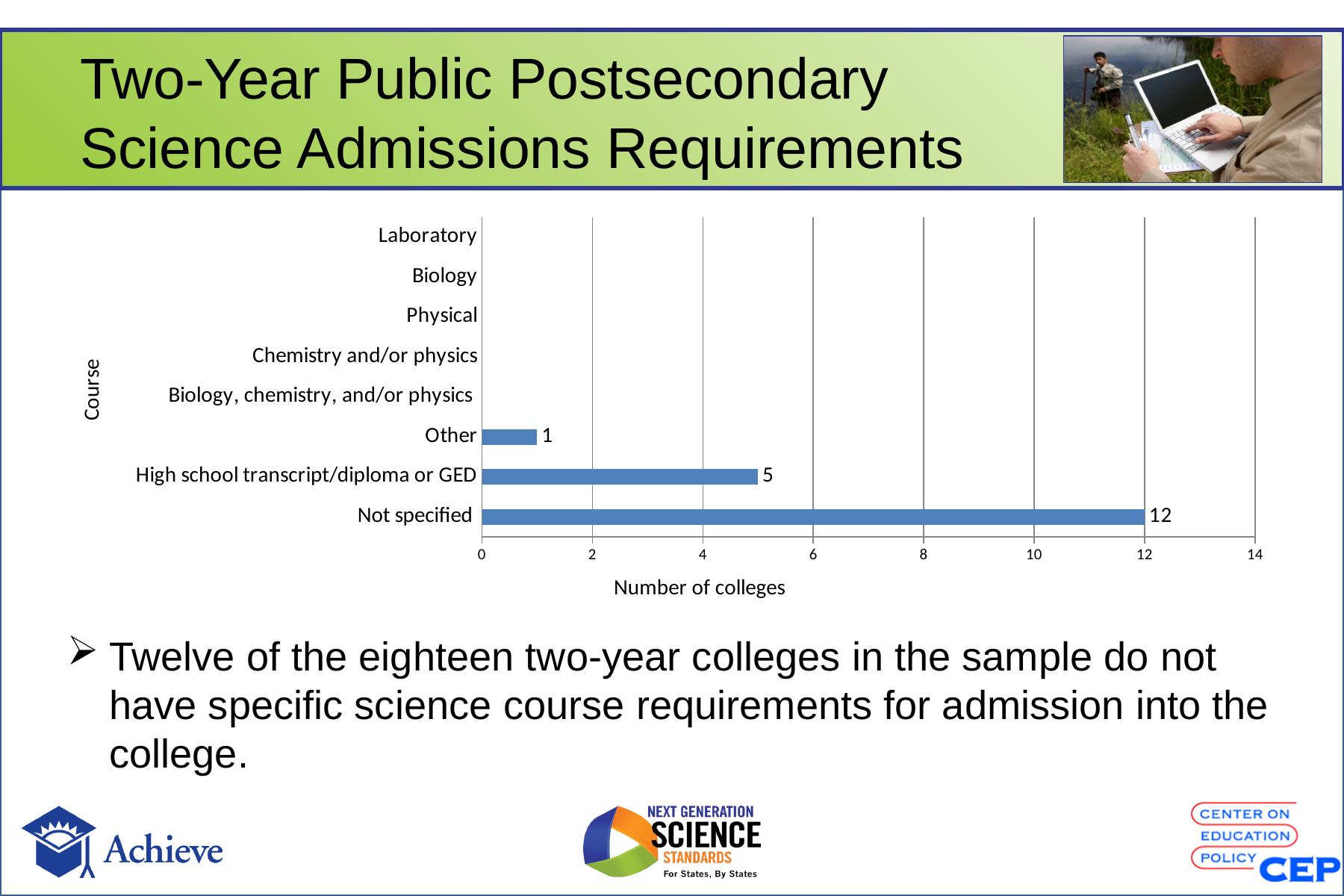
What kind of chart is shown on the slide? bar chart What is the difference between the values for High school transcript/diploma or GED and Other? 4 What is the title of the vertical axis of the chart? Course What is the value for Other? 1 How many categories are listed on the vertical axis of the chart? 8 What is the difference between the values for Not specified and High school transcript/diploma or GED? 7 Is the value for Not specified greater or less than 10? greater What is the title of the horizontal axis of the chart? Number of colleges Which is larger, the value for Other or the value for High school transcript/diploma or GED? High school transcript/diploma or GED How many colleges are shown for High school transcript/diploma or GED? 5 Which category has the highest number of colleges? Not specified What is the value for Not specified? 12